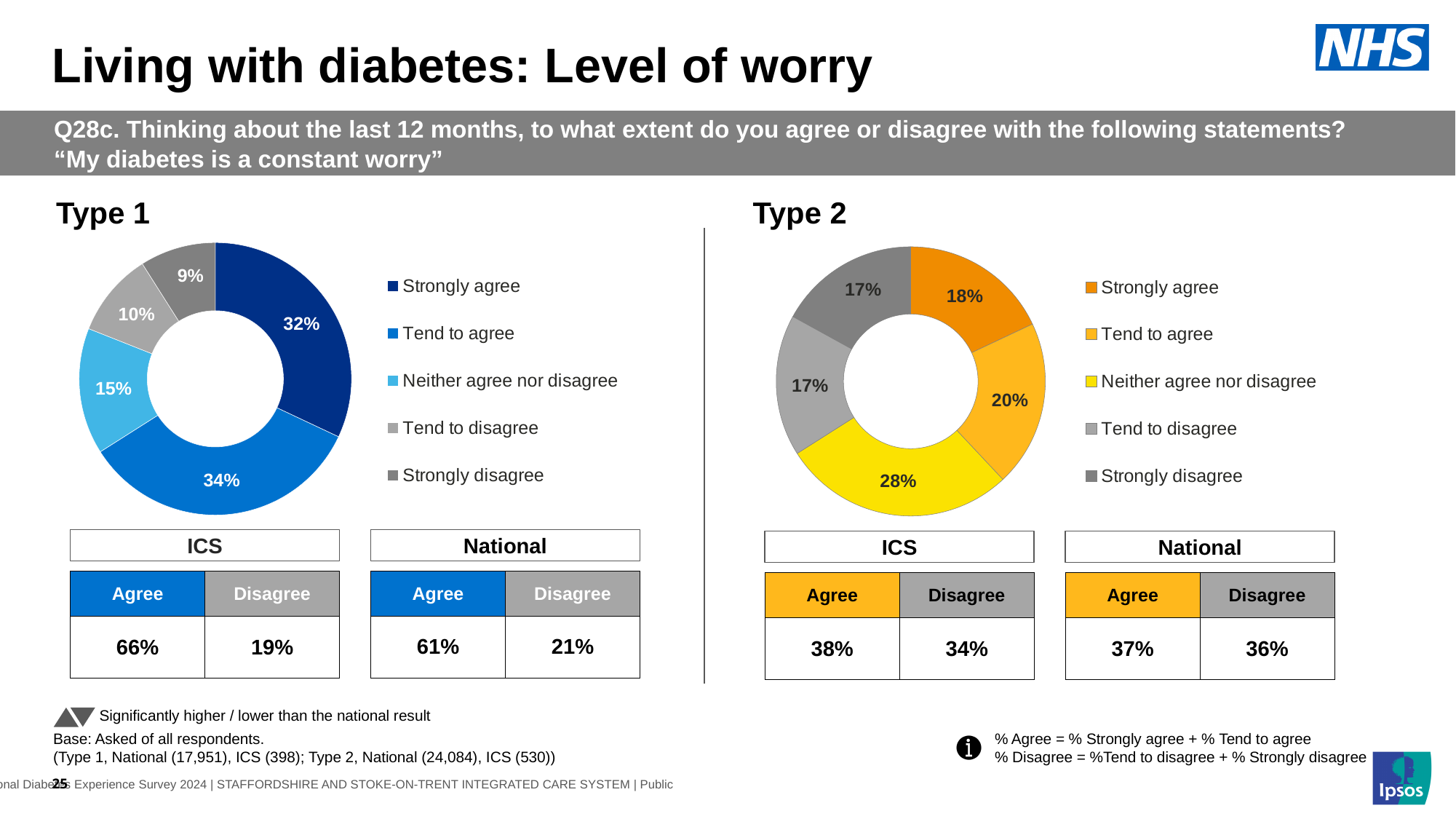
What type of chart is used to show the Type 1 results? Doughnut (pie) chart How many response categories does the legend of the Type 2 chart list? 5 In the Type 2 chart, what is the combined share of Tend to disagree and Strongly disagree? 34% In the Type 2 chart, what percentage of respondents said they neither agree nor disagree? 28% In the Type 2 chart, what colour is the Neither agree nor disagree segment? Yellow In the Type 1 chart, what is the combined share of Strongly agree and Tend to agree? 66% In the Type 1 chart, is the share for Tend to agree larger or smaller than the share for Neither agree nor disagree? Larger In the Type 1 chart, what percentage of respondents said they strongly agree? 32% In the Type 1 chart, which response category has the largest share? Tend to agree In the Type 1 chart, which response category has the smallest share? Strongly disagree In the Type 2 chart, which response category has the largest share? Neither agree nor disagree In the Type 2 chart, what is the difference between the Neither agree nor disagree share and the Strongly agree share? 10 percentage points